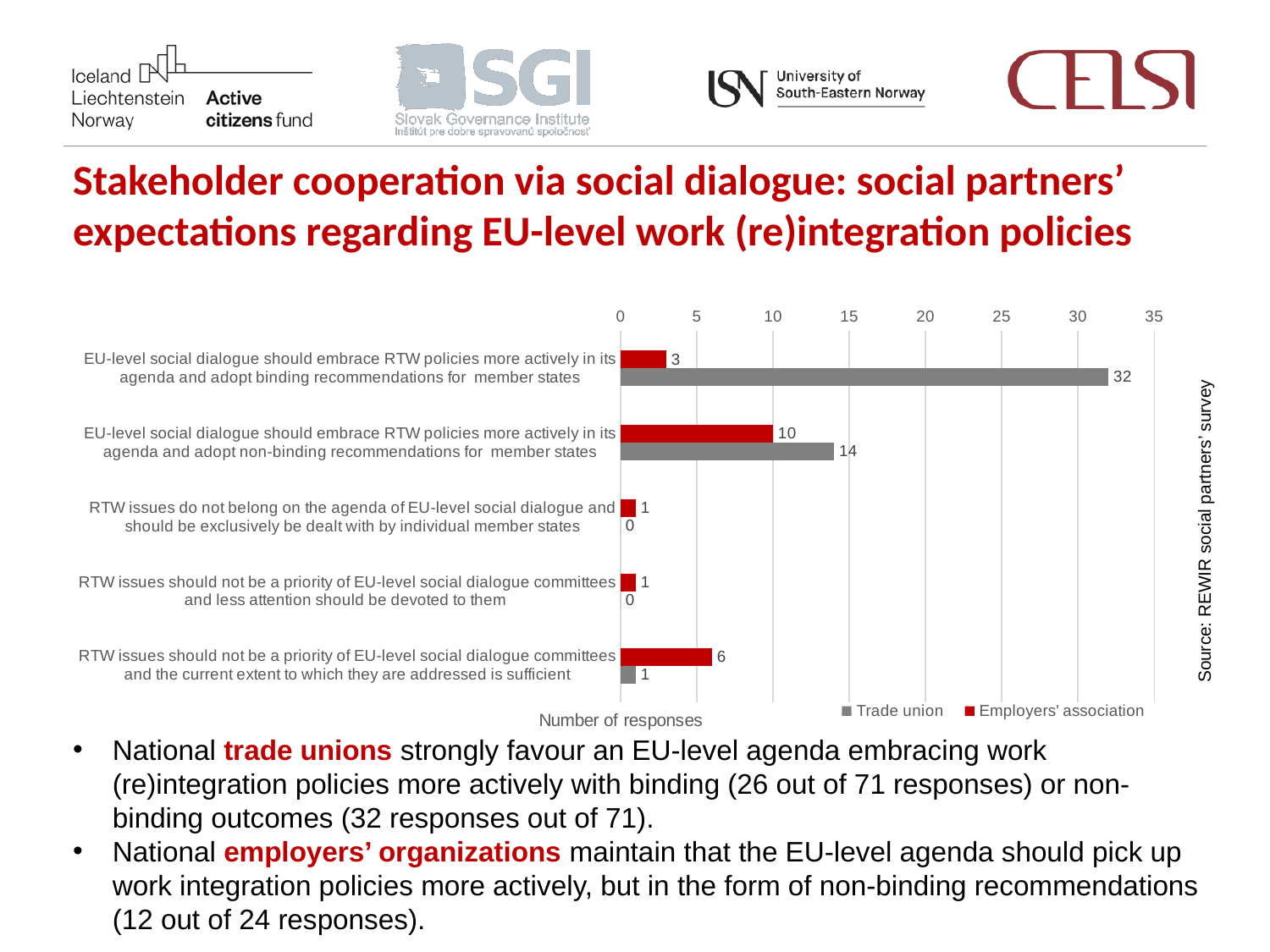
Which statement has the highest Trade union value? EU-level social dialogue should embrace RTW policies more actively in its agenda and adopt binding recommendations for member states How many categories (statements) are plotted in the chart? 5 What is the total of the Trade union and Employers' association values for the statement about adopting non-binding recommendations for member states? 24 What is the Trade union value for 'RTW issues should not be a priority of EU-level social dialogue committees and the current extent to which they are addressed is sufficient'? 1 What is the difference between the Trade union and Employers' association values for the statement about adopting binding recommendations for member states? 29 What is the Trade union value for 'EU-level social dialogue should embrace RTW policies more actively in its agenda and adopt binding recommendations for member states'? 32 What is the Employers' association value for 'EU-level social dialogue should embrace RTW policies more actively in its agenda and adopt non-binding recommendations for member states'? 10 What is the label of the horizontal axis of the chart? Number of responses Which statement has the highest Employers' association value? EU-level social dialogue should embrace RTW policies more actively in its agenda and adopt non-binding recommendations for member states For the statement about adopting non-binding recommendations for member states, which series has the larger value, Trade union or Employers' association? Trade union What type of chart is shown on the slide? bar chart How many series does the chart legend list? 2